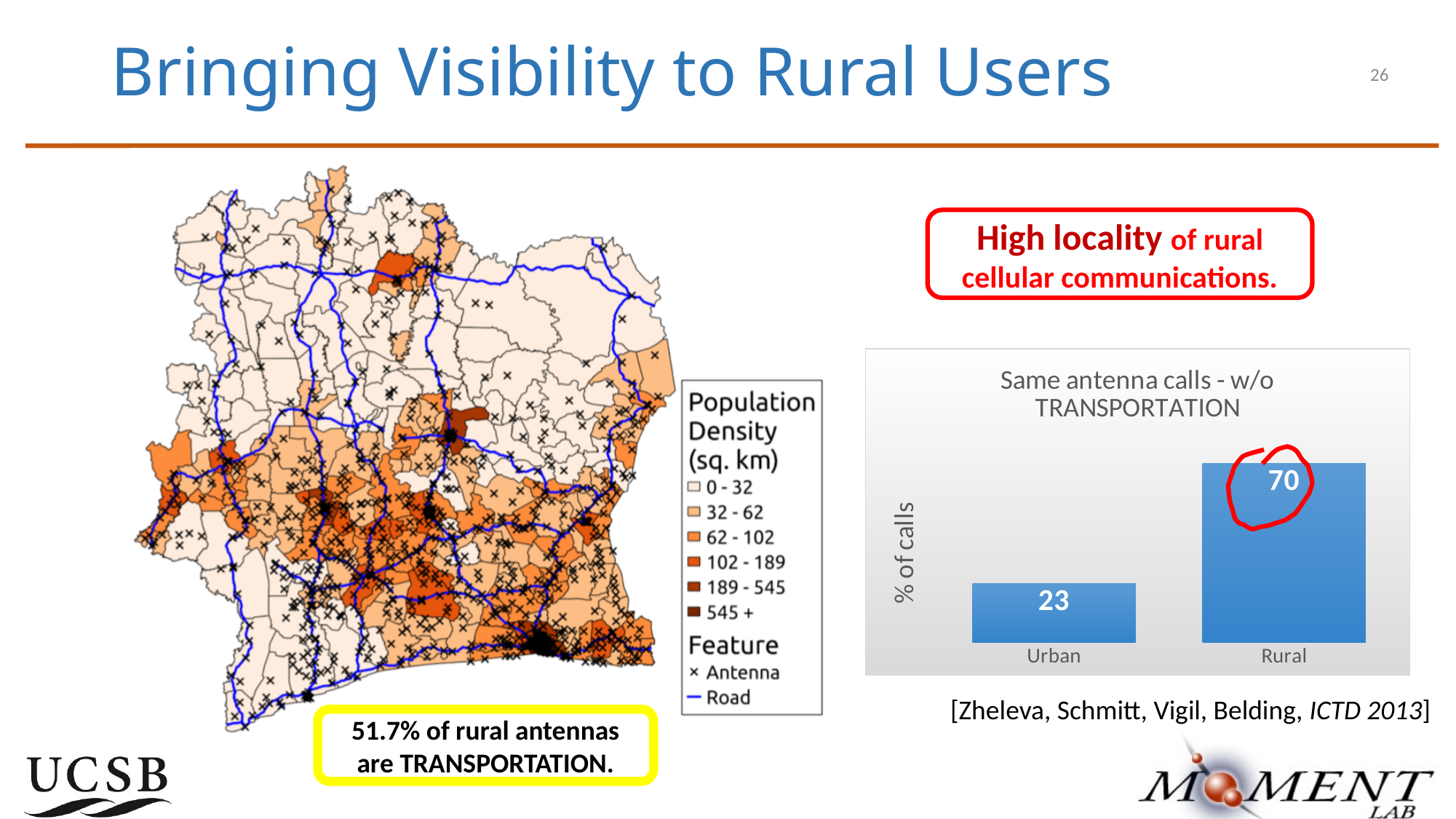
Which category has the highest value in the 'Same antenna calls - w/o TRANSPORTATION' chart? Rural What is the difference between the Rural and Urban values in the 'Same antenna calls - w/o TRANSPORTATION' chart? 47 What is the title of the bar chart on the right of the slide? Same antenna calls - w/o TRANSPORTATION What is the value for Urban in the 'Same antenna calls - w/o TRANSPORTATION' chart? 23 What is the y-axis label of the 'Same antenna calls - w/o TRANSPORTATION' chart? % of calls What is the value for Rural in the 'Same antenna calls - w/o TRANSPORTATION' chart? 70 What is the total of the Urban and Rural values in the 'Same antenna calls - w/o TRANSPORTATION' chart? 93 In the 'Same antenna calls - w/o TRANSPORTATION' chart, is the value for Urban or Rural larger? Rural Which category has the lowest value in the 'Same antenna calls - w/o TRANSPORTATION' chart? Urban How many categories are shown in the 'Same antenna calls - w/o TRANSPORTATION' chart? 2 What kind of chart is the 'Same antenna calls - w/o TRANSPORTATION' chart? bar chart